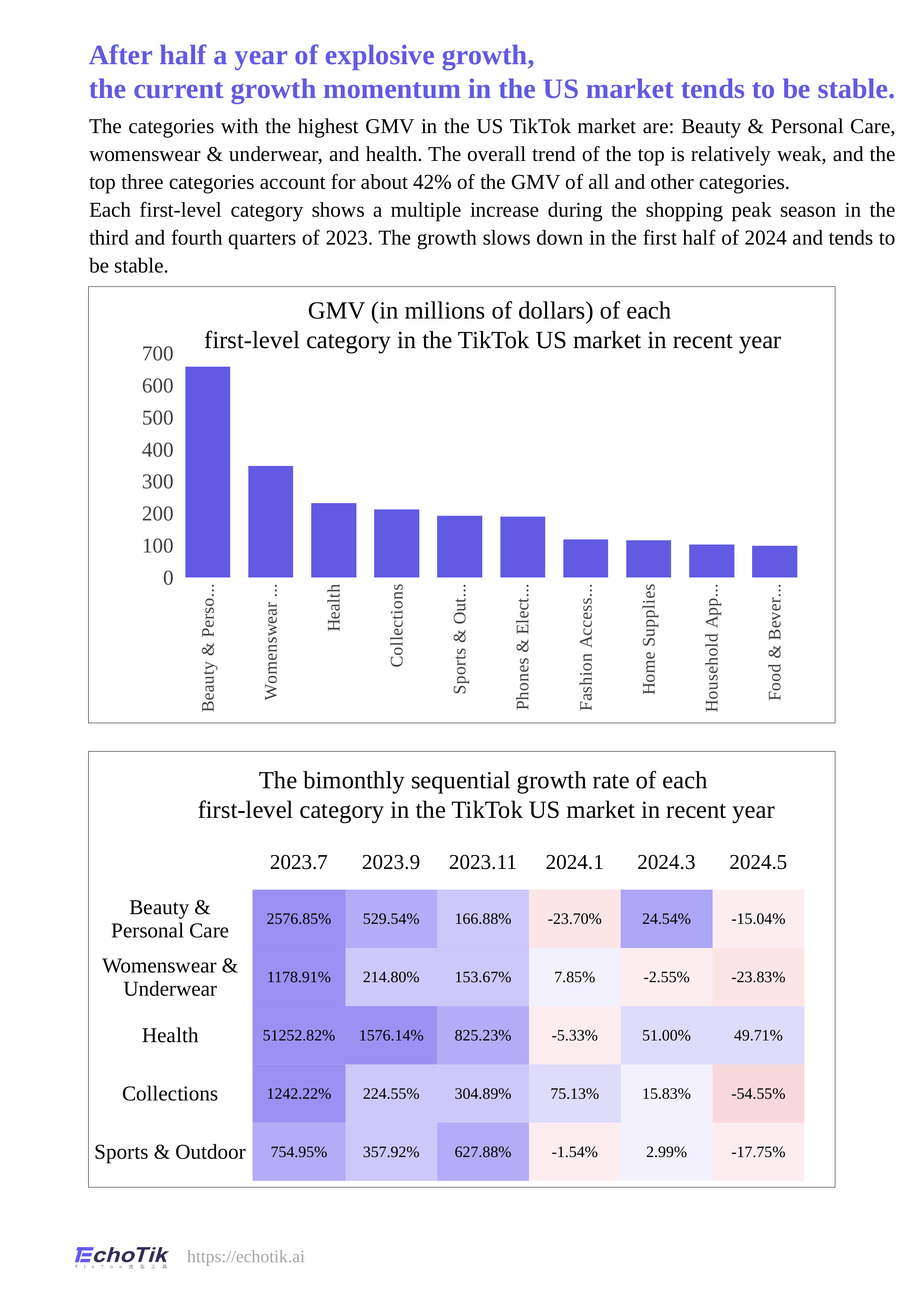
In the top GMV bar chart, how many categories are plotted? 10 In the bottom growth-rate table, which is larger for Sports & Outdoor: the 2023.9 value or the 2023.11 value? 2023.11 In the top GMV bar chart, which category has the highest GMV? Beauty & Personal Care In the bottom growth-rate table, which period has the lowest growth rate for Beauty & Personal Care? 2024.1 In the bottom growth-rate table, what is the growth rate for Collections in 2024.5? -54.55% In the top GMV bar chart, is the value for Home Supplies greater or less than 100? greater In the top GMV bar chart, is the value for Womenswear greater or less than 300? greater In the bottom growth-rate table, what is the growth rate for Health in 2023.7? 51252.82% In the bottom growth-rate table, how many time periods are shown as columns? 6 In the top GMV bar chart, do the bar values rise or fall from left to right along the x axis? fall What kind of chart is the top chart titled "GMV (in millions of dollars) of each first-level category in the TikTok US market in recent year"? bar chart In the top GMV bar chart, is the value for Beauty & Personal Care greater or less than 600? greater